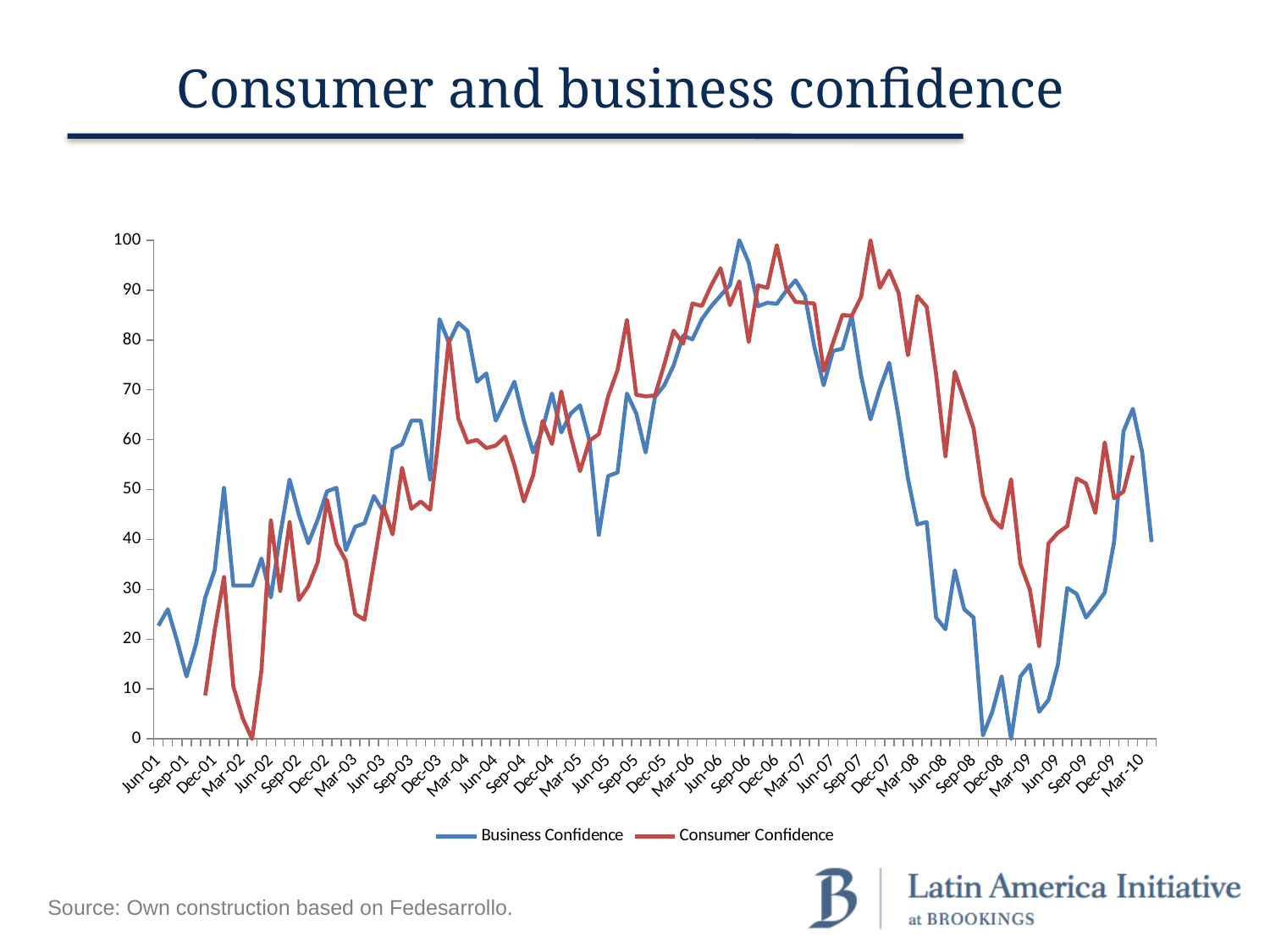
How many series does the legend list? 2 At Dec-08, which series has the larger value, Business Confidence or Consumer Confidence? Consumer Confidence Which colour is used for the Consumer Confidence line? red What is the title of the chart? Consumer and business confidence What kind of chart is shown on the slide? line chart Is the value for Consumer Confidence at Dec-07 greater or less than 90? greater At Mar-04, which series has the larger value, Business Confidence or Consumer Confidence? Business Confidence Is the value for Business Confidence at Jun-01 greater or less than 30? less Is the value for Business Confidence at Sep-06 greater or less than 90? greater Does Business Confidence rise or fall between Dec-07 and Dec-08? fall